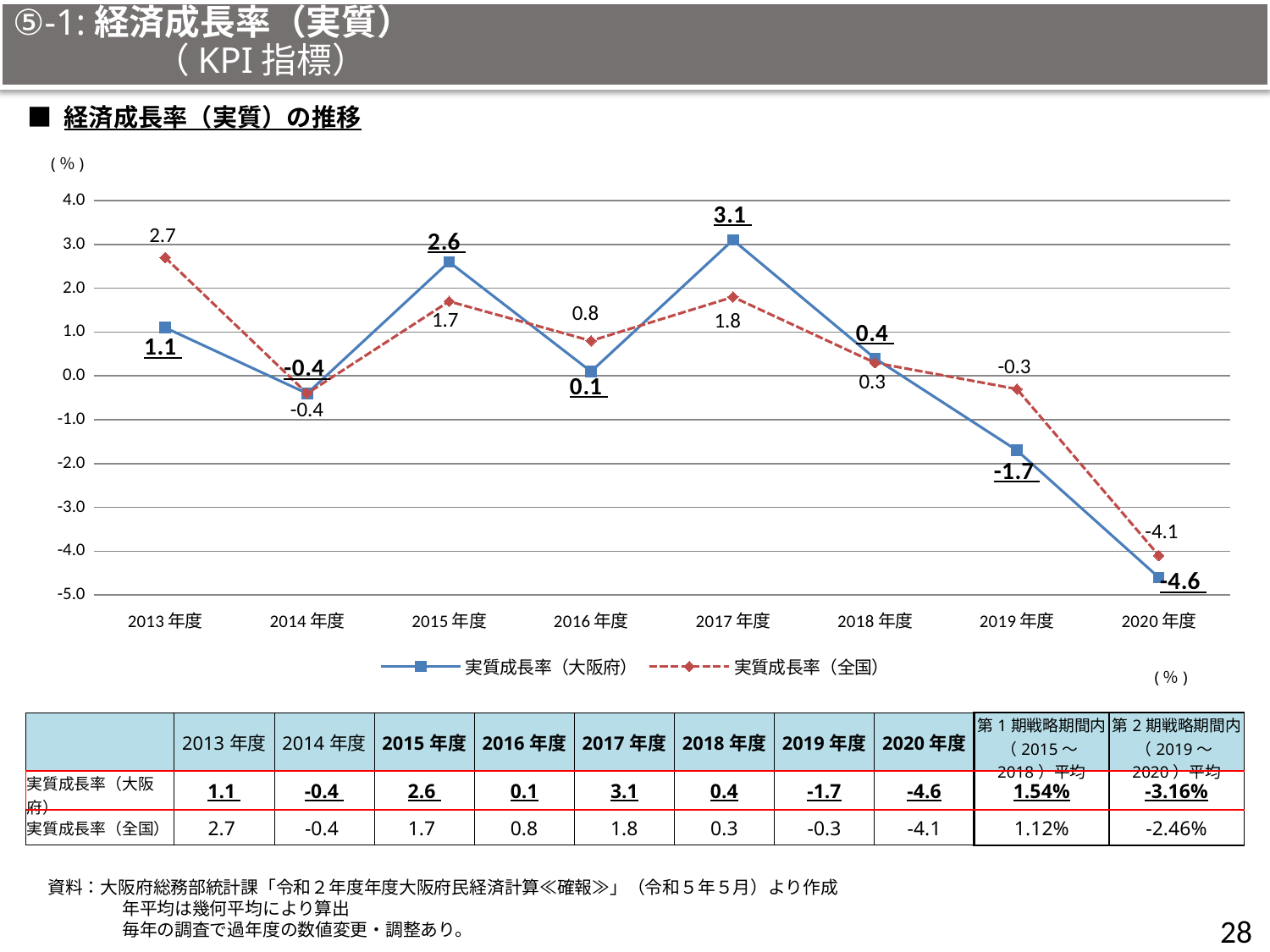
What is the value for 実質成長率（大阪府） in 2017年度? 3.1 What is the difference between 実質成長率（大阪府） and 実質成長率（全国） in 2015年度? 0.9 In which year is 実質成長率（大阪府） highest? 2017年度 What kind of chart is shown on the slide? line chart Which is larger in 2016年度, 実質成長率（大阪府） or 実質成長率（全国）? 実質成長率（全国） What is the value for 実質成長率（全国） in 2013年度? 2.7 Does 実質成長率（大阪府） rise or fall from 2017年度 to 2020年度? fall In which year is 実質成長率（全国） lowest? 2020年度 How many years are shown on the x axis of the chart? 8 How many series does the chart legend list? 2 What is the value for 実質成長率（大阪府） in 2020年度? -4.6 Is the value for 実質成長率（大阪府） in 2019年度 greater or less than -1.0? less